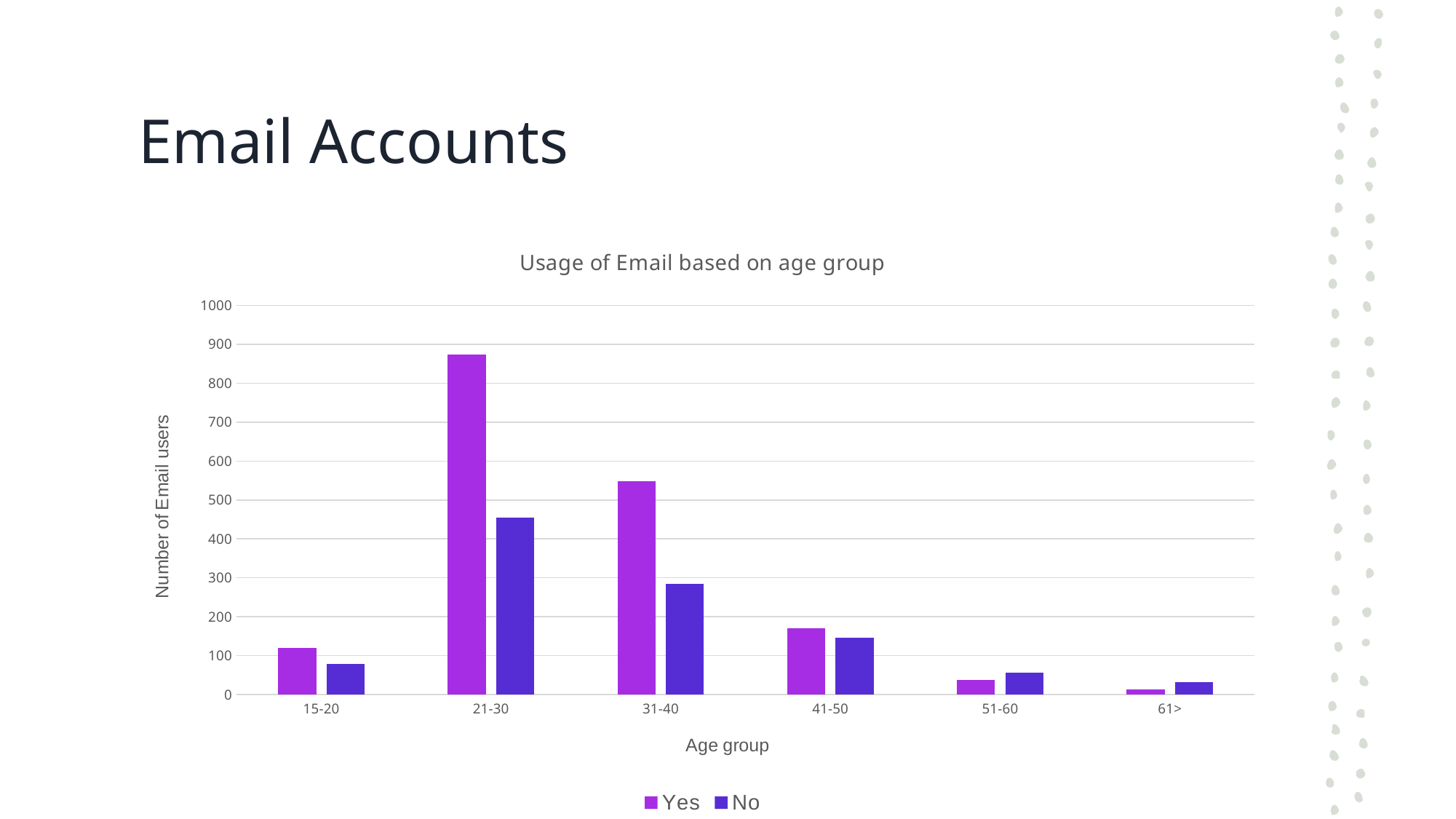
From the 21-30 age group onward, do the Yes values rise or fall as age increases? fall Is the Yes value for the 31-40 age group greater or less than 500? greater How many series does the legend list? 2 Which age group has the highest value for the No series? 21-30 What is the title of the chart? Usage of Email based on age group Which age group has the highest value for the Yes series? 21-30 How many age groups are shown on the x axis? 6 For the 51-60 age group, which series has the larger value, Yes or No? No Is the Yes value for the 21-30 age group greater or less than 800? greater Which age group has the lowest value for the Yes series? 61> What kind of chart is shown on the slide? bar chart Is the No value for the 21-30 age group greater or less than 500? less